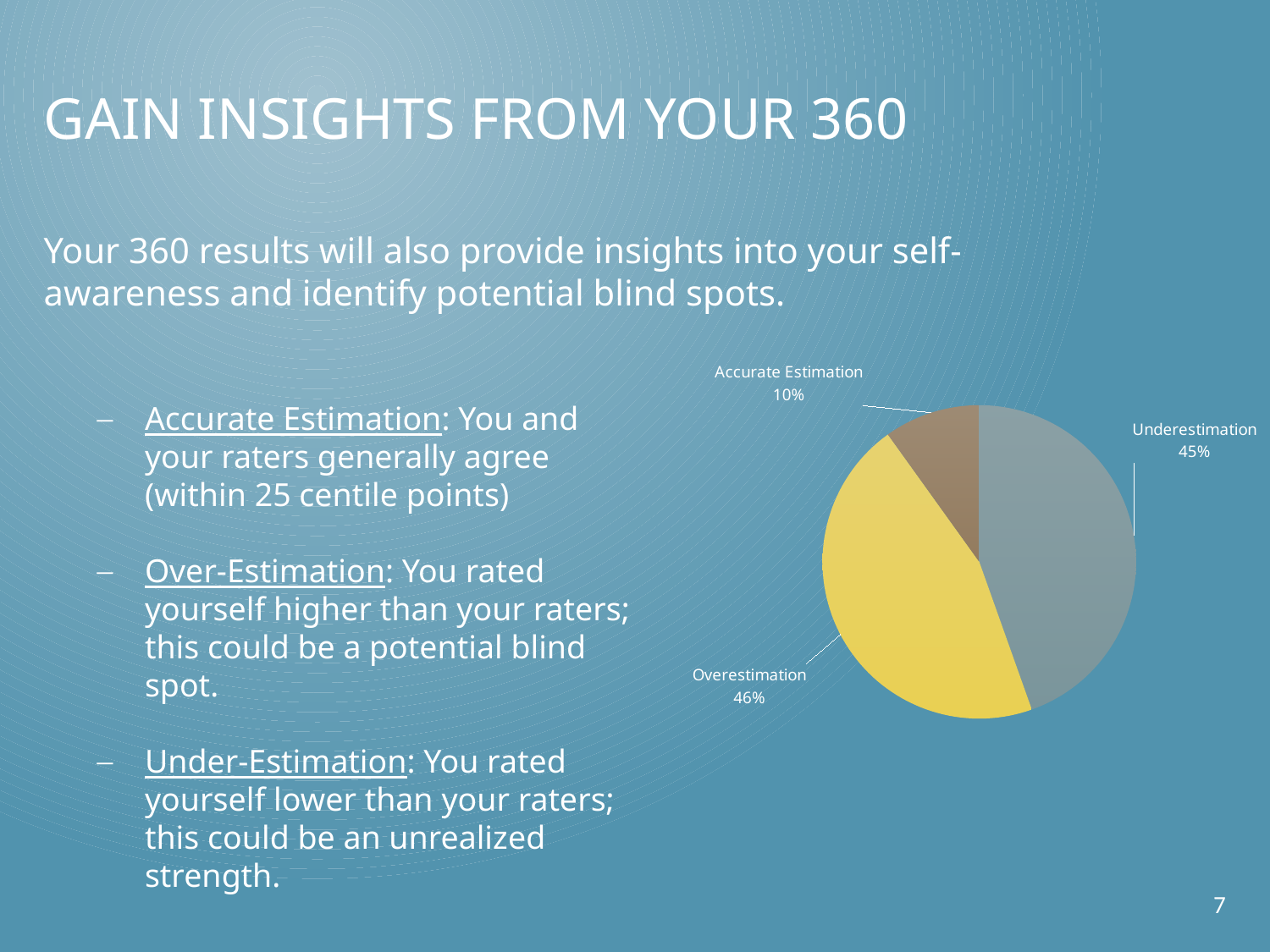
Which slice of the pie chart is the largest? Overestimation What percentage is shown for Overestimation in the pie chart? 46% Which is larger in the pie chart, Underestimation or Accurate Estimation? Underestimation What percentage is shown for Underestimation in the pie chart? 45% Which slice of the pie chart is the smallest? Accurate Estimation What is the difference in percentage points between Overestimation and Accurate Estimation? 36 How many slices does the pie chart have? 3 What colour is the Overestimation slice in the pie chart? yellow What kind of chart is shown on the slide? pie chart What percentage is shown for Accurate Estimation in the pie chart? 10% What share of the pie does Overestimation represent? 46% What is the difference in percentage points between Underestimation and Accurate Estimation? 35